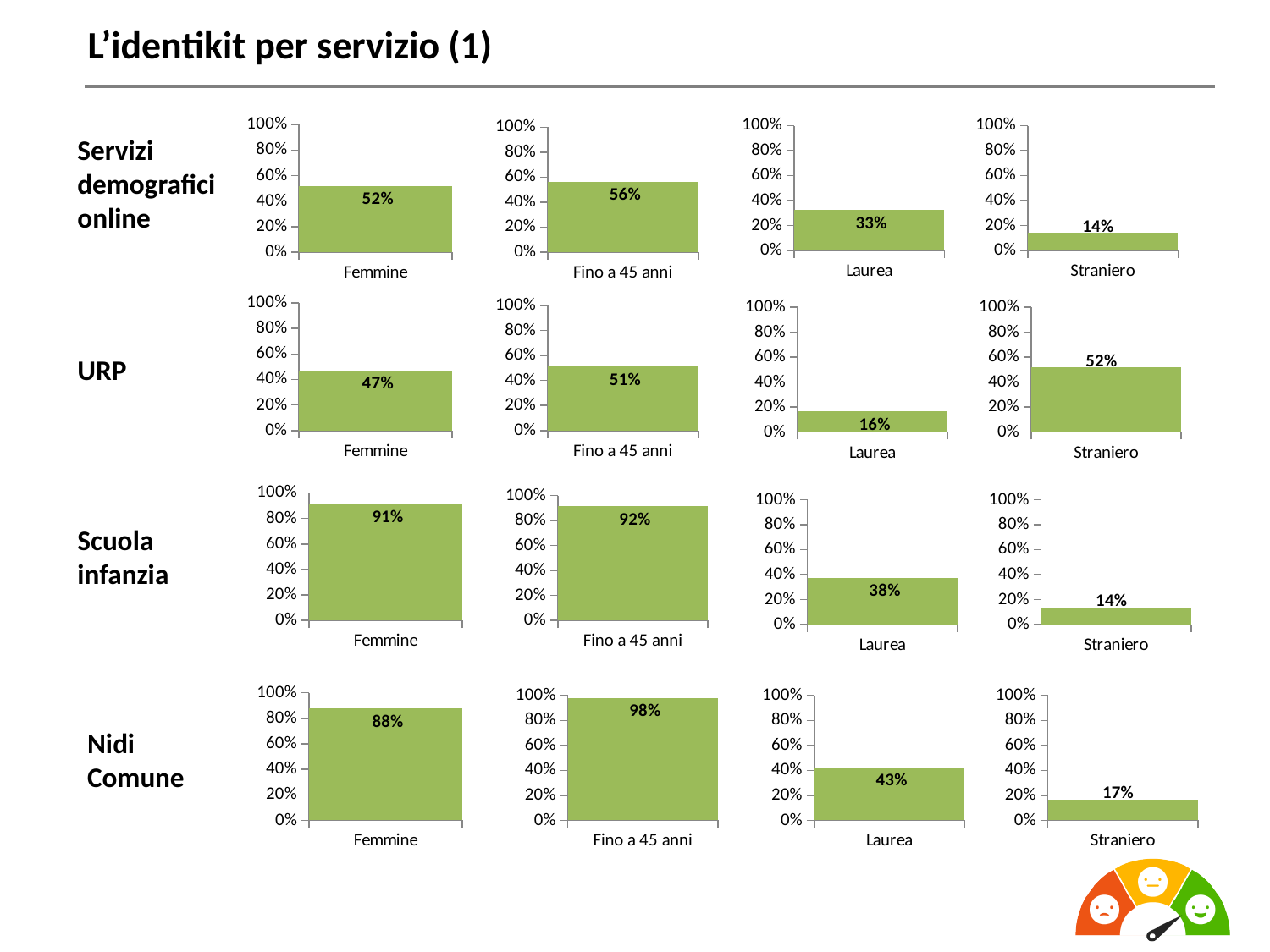
In the Nidi Comune row, what is the difference between the Fino a 45 anni value and the Laurea value? 55% In the Servizi demografici online row, what is the value shown for Femmine? 52% In the Scuola infanzia row, is the value for Laurea greater or less than 40%? less What is the title of the slide? L'identikit per servizio (1) In the URP row, which is larger: the value for Straniero or the value for Femmine? Straniero What kind of chart is used in the Nidi Comune Femmine chart? bar chart Across the four Straniero charts, which row has the highest value? URP In the Nidi Comune row, what is the value shown for Straniero? 17% Across the four Laurea charts, which row has the lowest value? URP In the Scuola infanzia row, what is the value shown for Fino a 45 anni? 92% In the URP row, what is the value shown for Laurea? 16% How many small charts are shown on the slide in total? 16